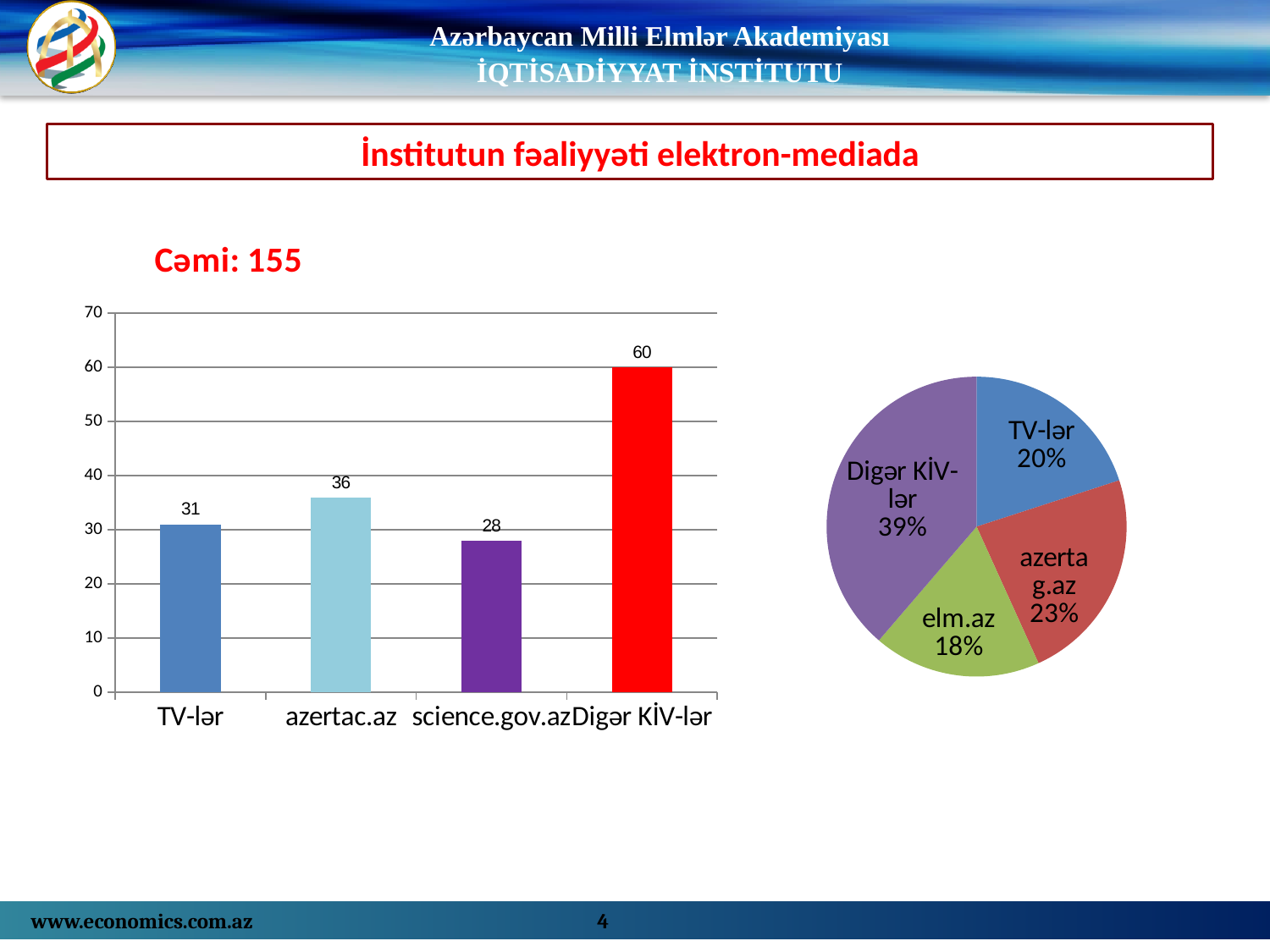
In the bar chart on the left, what is the value for science.gov.az? 28 In the pie chart on the right, what share does elm.az have? 18% In the pie chart on the right, what share does Digər KİV-lər have? 39% In the bar chart on the left, what is the difference between the values for Digər KİV-lər and TV-lər? 29 In the bar chart on the left, which is larger: the value for TV-lər or the value for azertac.az? azertac.az In the bar chart on the left, which category has the highest value? Digər KİV-lər In the bar chart on the left, how many categories are shown? 4 In the bar chart on the left, what is the value for azertac.az? 36 In the bar chart on the left, which category has the lowest value? science.gov.az What kind of chart is the chart on the left of the slide? bar chart In the pie chart on the right, which slice is the largest? Digər KİV-lər What total (Cəmi) is stated above the bar chart on the left? 155